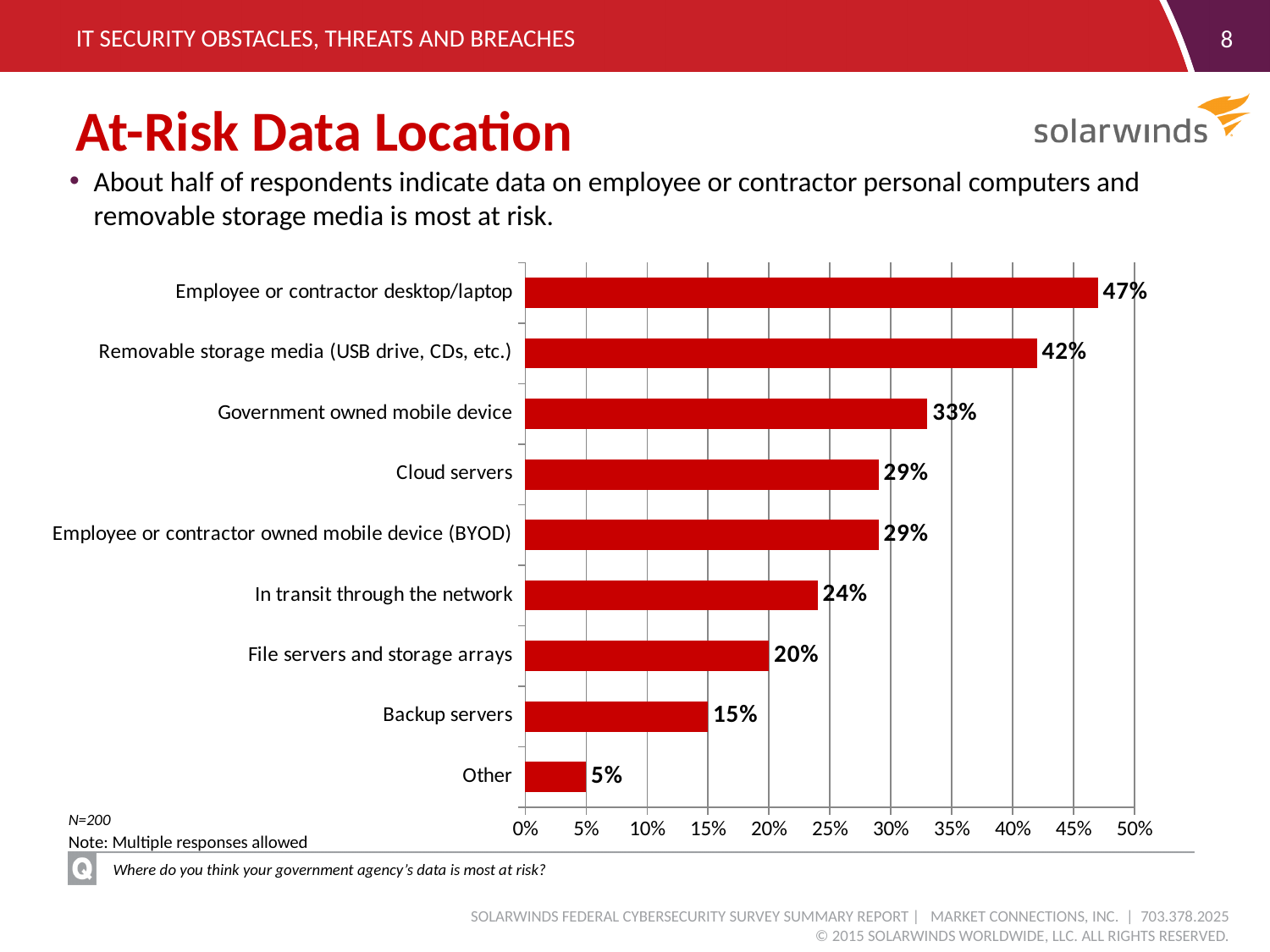
What percentage of respondents indicated data on employee or contractor desktop/laptop is most at risk? 47% What is the difference between the values for Employee or contractor desktop/laptop and Removable storage media (USB drive, CDs, etc.)? 5% What is the value for Backup servers? 15% What is the difference between the values for Government owned mobile device and Backup servers? 18% Which is larger, the value for In transit through the network or the value for File servers and storage arrays? In transit through the network What is the maximum value shown on the horizontal axis? 50% How many categories are shown in the chart? 9 Which category has the highest value? Employee or contractor desktop/laptop Is the value for Cloud servers greater or less than 25%? greater Which category has the lowest value? Other What kind of chart is shown on the slide? Bar chart What is the value for Removable storage media (USB drive, CDs, etc.)? 42%